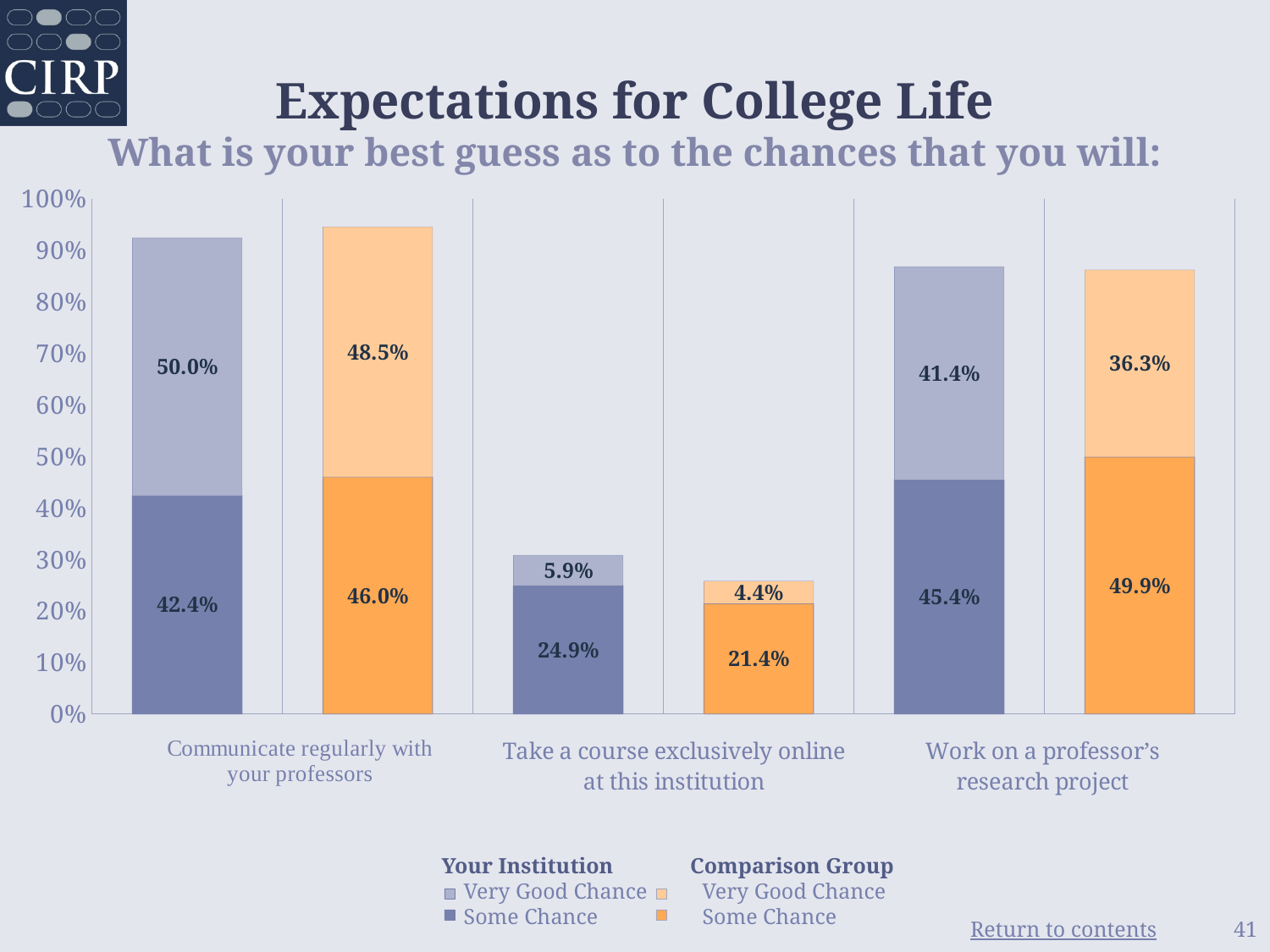
How many categories are shown on the x axis? 3 Which category has the lowest 'Very Good Chance' value for Your Institution? Take a course exclusively online at this institution What is the 'Very Good Chance' value for Your Institution for 'Communicate regularly with your professors'? 50.0% What kind of chart is shown on the slide? Stacked bar chart What is the total of the Your Institution stacked bar for 'Take a course exclusively online at this institution'? 30.8% What is the 'Very Good Chance' value for the Comparison Group for 'Work on a professor's research project'? 36.3% What is the 'Some Chance' value for Your Institution for 'Work on a professor's research project'? 45.4% How many series does the legend list? 4 Which is larger: the Your Institution 'Some Chance' value or the Comparison Group 'Some Chance' value for 'Communicate regularly with your professors'? Comparison Group (46.0%) What is the total of the Comparison Group stacked bar for 'Communicate regularly with your professors'? 94.5% What is the 'Some Chance' value for the Comparison Group for 'Take a course exclusively online at this institution'? 21.4% What is the difference between the Your Institution and Comparison Group 'Very Good Chance' values for 'Work on a professor's research project'? 5.1%